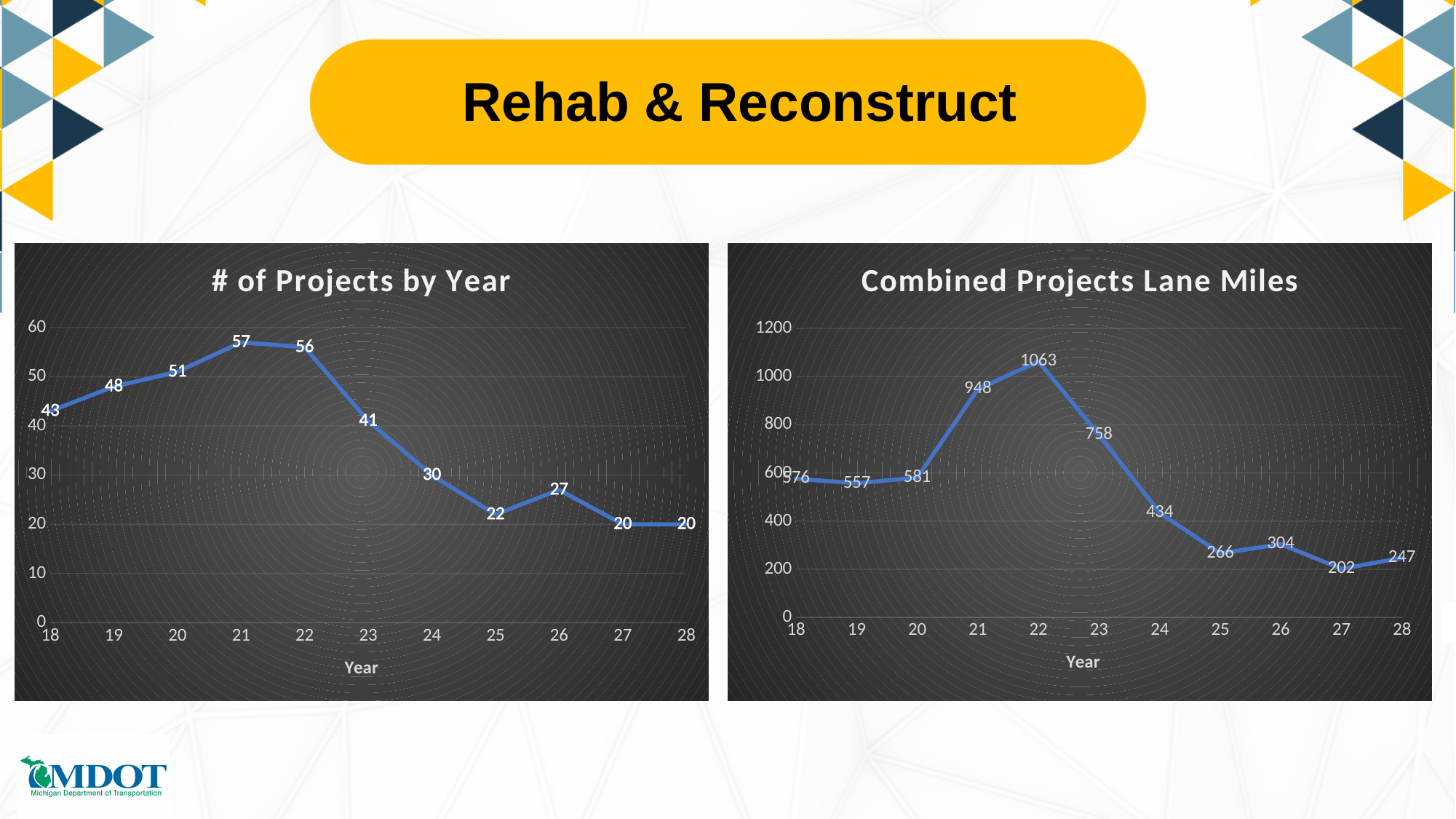
In the 'Combined Projects Lane Miles' chart, which is larger, the value for year 20 or the value for year 21? Year 21 What is the x-axis title of the 'Combined Projects Lane Miles' chart? Year In the 'Combined Projects Lane Miles' chart, what is the value for year 22? 1063 In the '# of Projects by Year' chart, how many years are plotted on the x axis? 11 In the 'Combined Projects Lane Miles' chart, what is the difference between the values for year 21 and year 22? 115 What kind of chart is '# of Projects by Year'? Line chart In the '# of Projects by Year' chart, what is the value for year 21? 57 In the 'Combined Projects Lane Miles' chart, which year has the lowest value? 27 In the '# of Projects by Year' chart, what is the difference between the values for year 22 and year 23? 15 In the '# of Projects by Year' chart, which year has the lowest number of projects? 27 and 28 (both 20) In the 'Combined Projects Lane Miles' chart, which year has the highest value? 22 In the '# of Projects by Year' chart, do the values generally rise or fall from year 22 to year 28? Fall